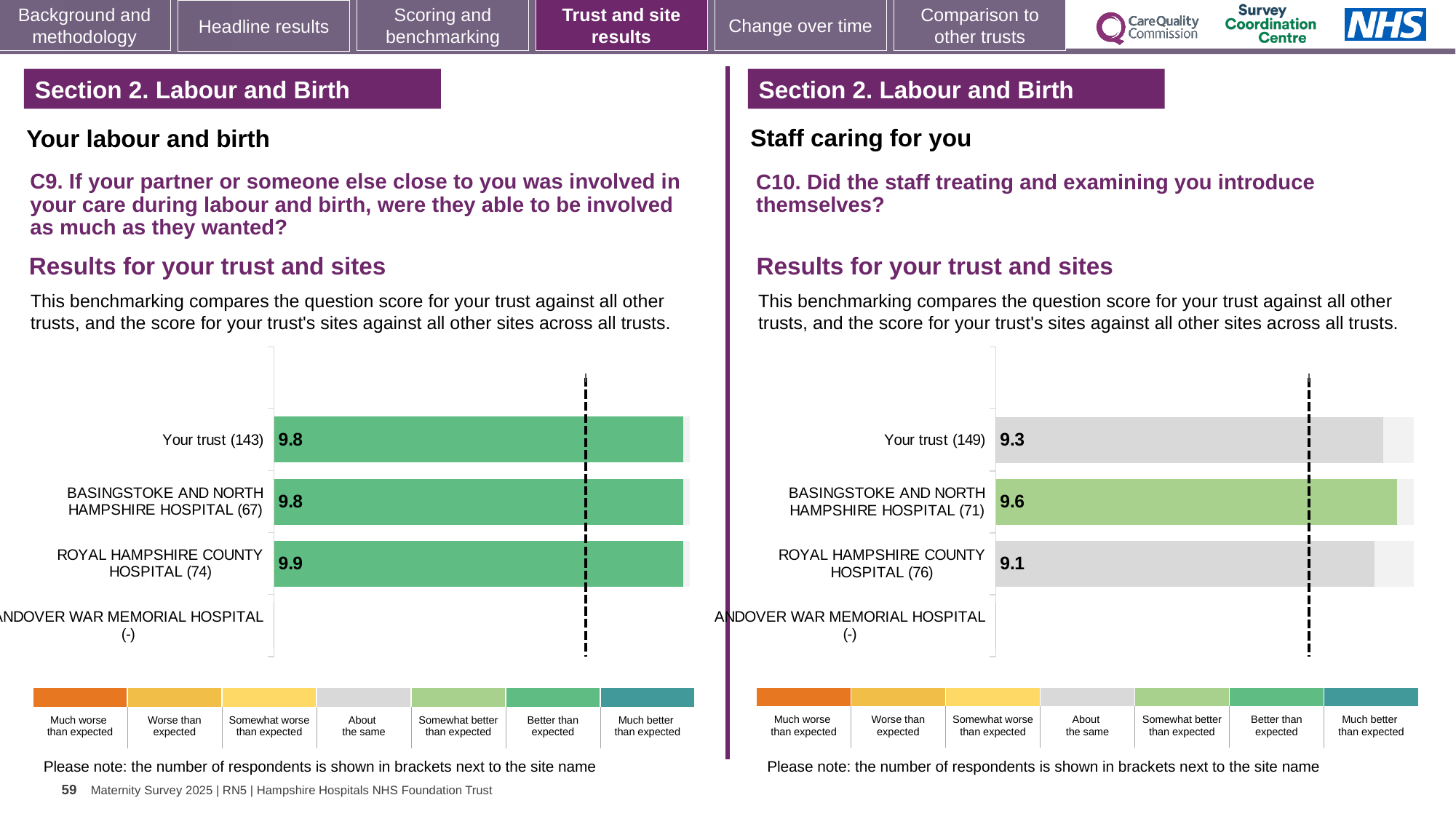
On the C10 chart (right), which is larger: the score for BASINGSTOKE AND NORTH HAMPSHIRE HOSPITAL (71) or ROYAL HAMPSHIRE COUNTY HOSPITAL (76)? BASINGSTOKE AND NORTH HAMPSHIRE HOSPITAL (71) What kind of chart is used on the C9 chart (left)? Bar chart On the C10 chart (right), what is the difference between the score for BASINGSTOKE AND NORTH HAMPSHIRE HOSPITAL (71) and Your trust (149)? 0.3 On the C9 chart (left), what is the score for ROYAL HAMPSHIRE COUNTY HOSPITAL (74)? 9.9 On the C10 chart (right), which site has the lowest score? ROYAL HAMPSHIRE COUNTY HOSPITAL (76) On the C10 chart (right), what is the score for Your trust (149)? 9.3 On the C10 chart (right), what is the score for ROYAL HAMPSHIRE COUNTY HOSPITAL (76)? 9.1 On the C9 chart (left), which site has the highest score? ROYAL HAMPSHIRE COUNTY HOSPITAL (74) On the C9 chart (left), what is the score for Your trust (143)? 9.8 On the C9 chart (left), what is the difference between the score for ROYAL HAMPSHIRE COUNTY HOSPITAL (74) and BASINGSTOKE AND NORTH HAMPSHIRE HOSPITAL (67)? 0.1 On the C10 chart (right), what is the score for BASINGSTOKE AND NORTH HAMPSHIRE HOSPITAL (71)? 9.6 On the C10 chart (right), how many respondents are shown in brackets for Your trust? 149